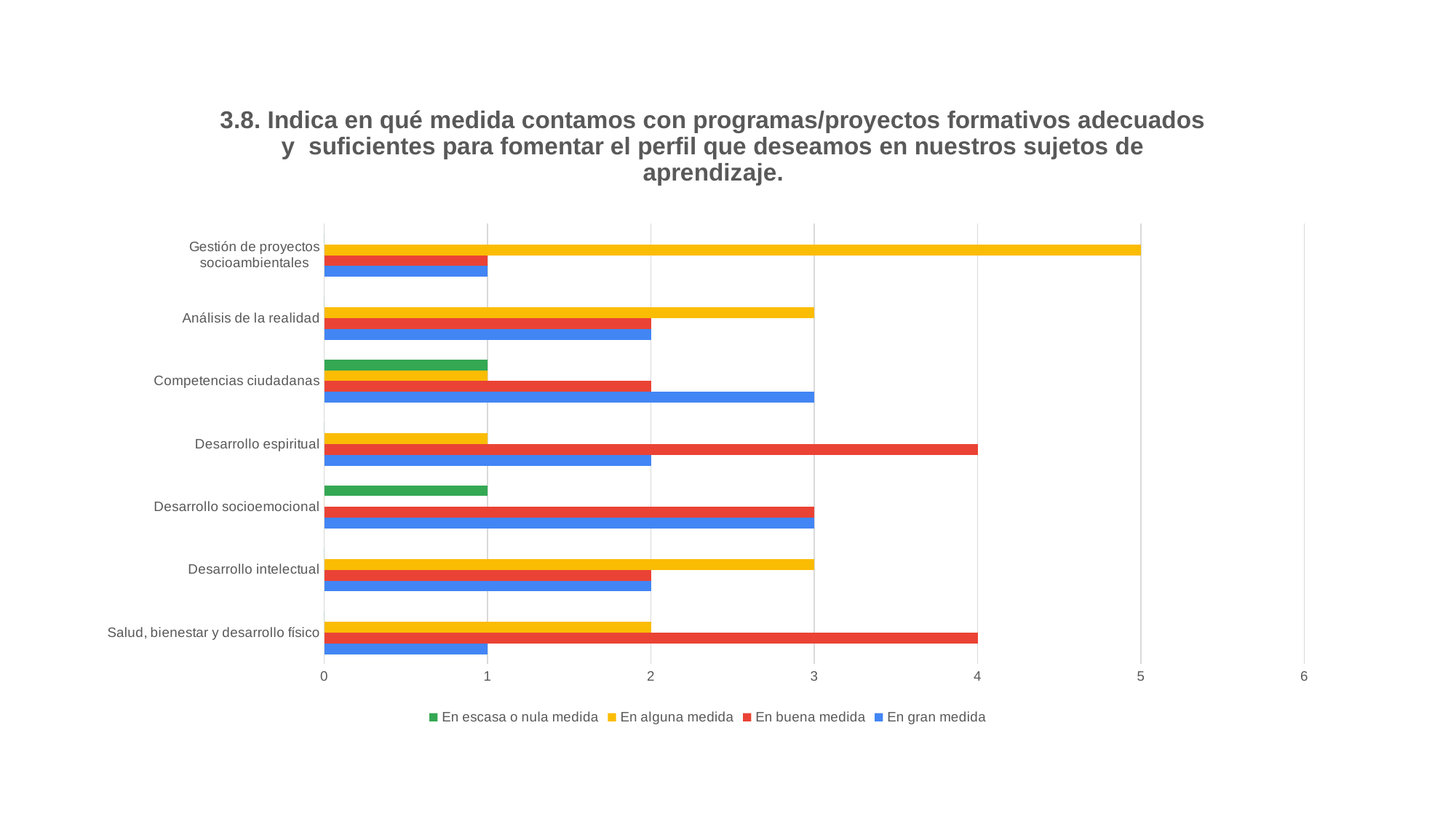
What kind of chart is shown on the slide? Bar chart What is the difference between 'En buena medida' and 'En gran medida' for 'Salud, bienestar y desarrollo físico'? 3 What is the value of 'En buena medida' for 'Desarrollo espiritual'? 4 How many series does the legend list? 4 Is the value of 'En alguna medida' for 'Gestión de proyectos socioambientales' greater or less than 4? greater What is the value of 'En alguna medida' for 'Gestión de proyectos socioambientales'? 5 Which category has the highest value for 'En alguna medida'? Gestión de proyectos socioambientales What is the value of 'En gran medida' for 'Competencias ciudadanas'? 3 For 'Desarrollo espiritual', which is larger: 'En buena medida' or 'En gran medida'? En buena medida How many categories are plotted on the chart? 7 Which colour represents 'En escasa o nula medida' in the legend? Green Which category has the lowest value for 'En buena medida'? Gestión de proyectos socioambientales